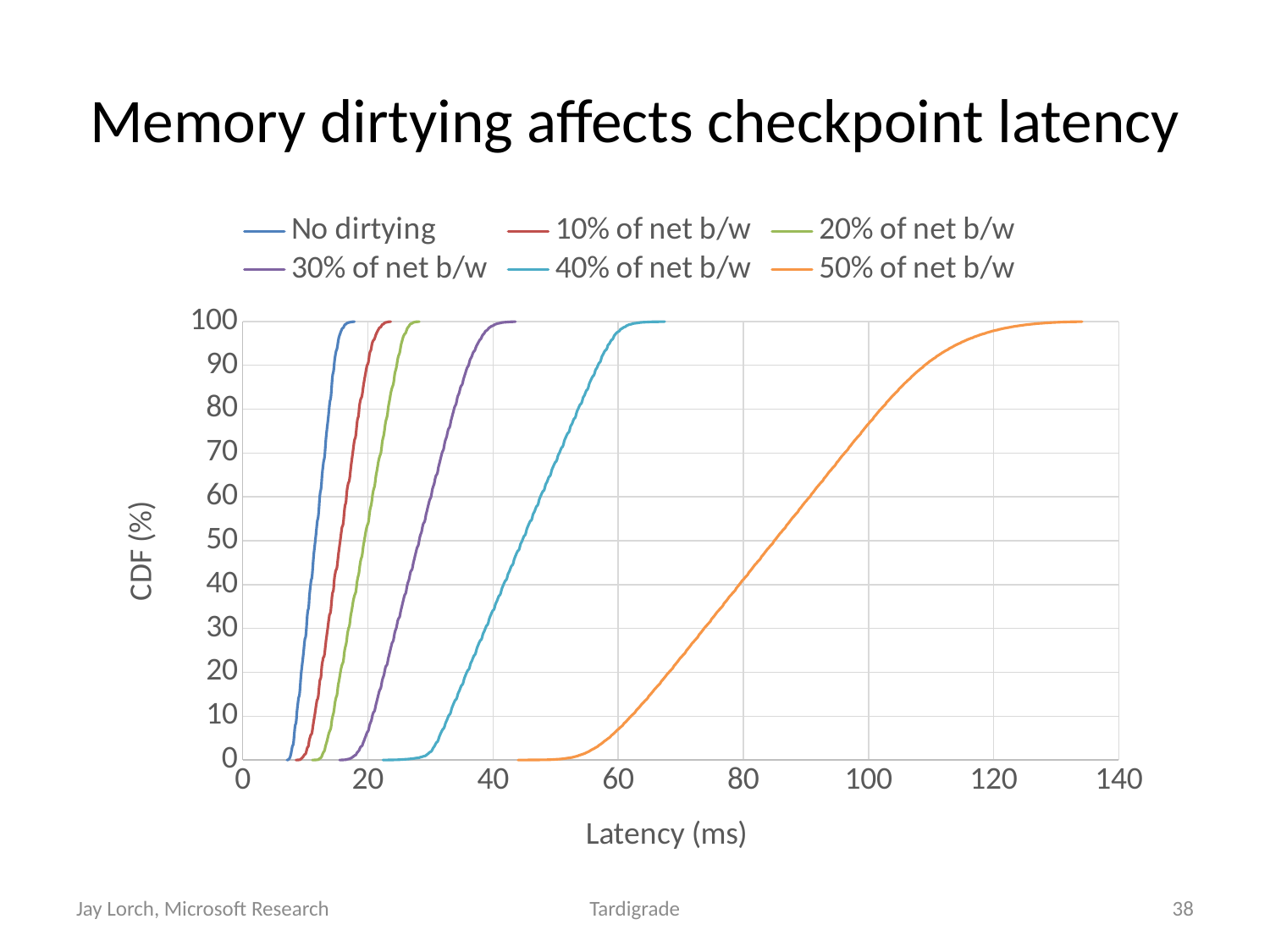
What kind of chart is shown on the slide? Line chart What is the title of the chart? Memory dirtying affects checkpoint latency Is the latency at which the 40% of net b/w curve reaches 100% greater or less than 80? less How many series does the legend list? 6 Which series reaches 100% CDF at the highest latency? 50% of net b/w Is the latency at which the 50% of net b/w curve reaches 100% greater or less than 120? greater Is the latency at which the No dirtying curve reaches 100% greater or less than 20? less Which series reaches 100% CDF at the lowest latency? No dirtying Do the CDF values rise or fall as latency increases along the x axis? Rise What is the label of the x axis? Latency (ms) Which series reaches 100% CDF at a higher latency, 20% of net b/w or 30% of net b/w? 30% of net b/w